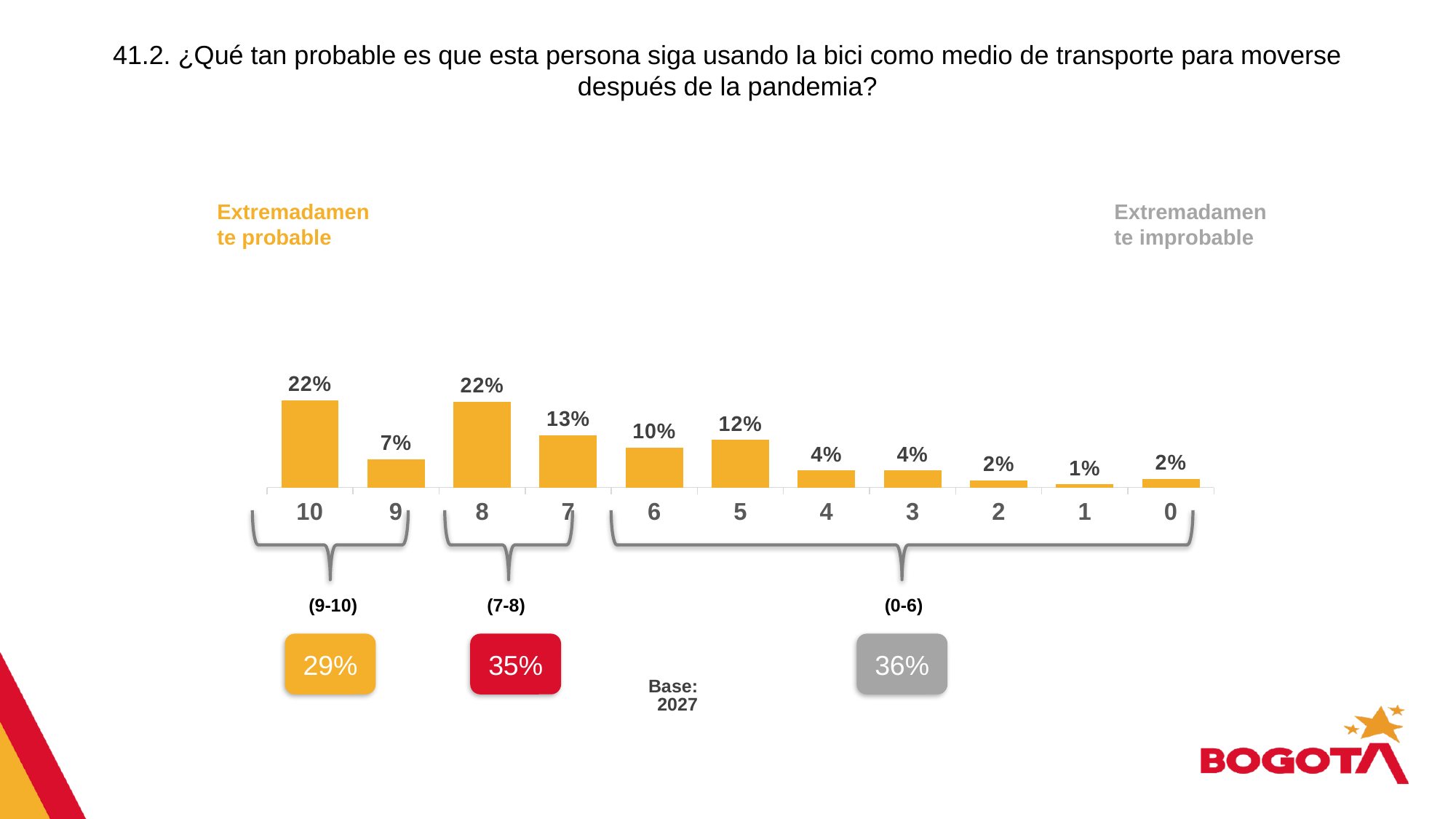
What is the value for category 5? 12% What is the difference between the values for category 8 and category 9? 15% What is the value for category 7? 13% What is the combined percentage shown for the (0-6) group? 36% How many categories are shown on the x axis? 11 What is the value for category 10? 22% What kind of chart is shown on the slide? bar chart What is the value for category 1? 1% Which category has the lowest value? 1 What is the combined percentage shown for the (9-10) group? 29% What is the base (sample size) shown on the slide? 2027 Which is larger, the value for category 6 or the value for category 5? 5